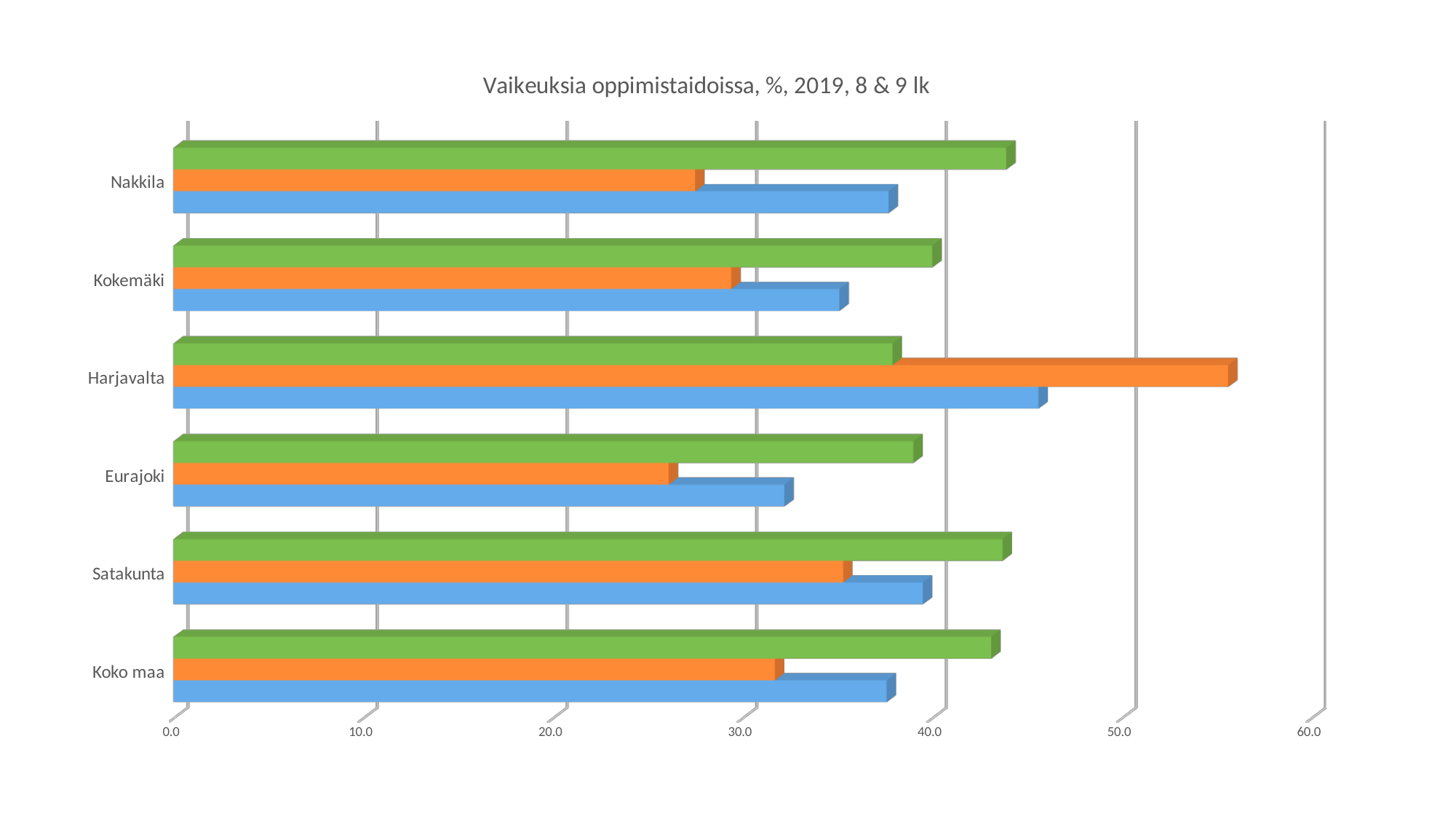
Which category has the longest orange bar? Harjavalta How many bars are shown for each category in the chart? 3 For Nakkila, which is larger: the green bar or the orange bar? the green bar Which category has the longest blue bar? Harjavalta What kind of chart is shown on the slide? bar chart Is the value of the green bar for Satakunta greater or less than 40? greater Is the value of the orange bar for Harjavalta greater or less than 50? greater What is the title of the chart? Vaikeuksia oppimistaidoissa, %, 2019, 8 & 9 lk Which category has the shortest blue bar? Eurajoki Is the value of the orange bar for Eurajoki greater or less than 30? less For Harjavalta, which is larger: the orange bar or the green bar? the orange bar How many categories are shown on the vertical axis of the chart? 6